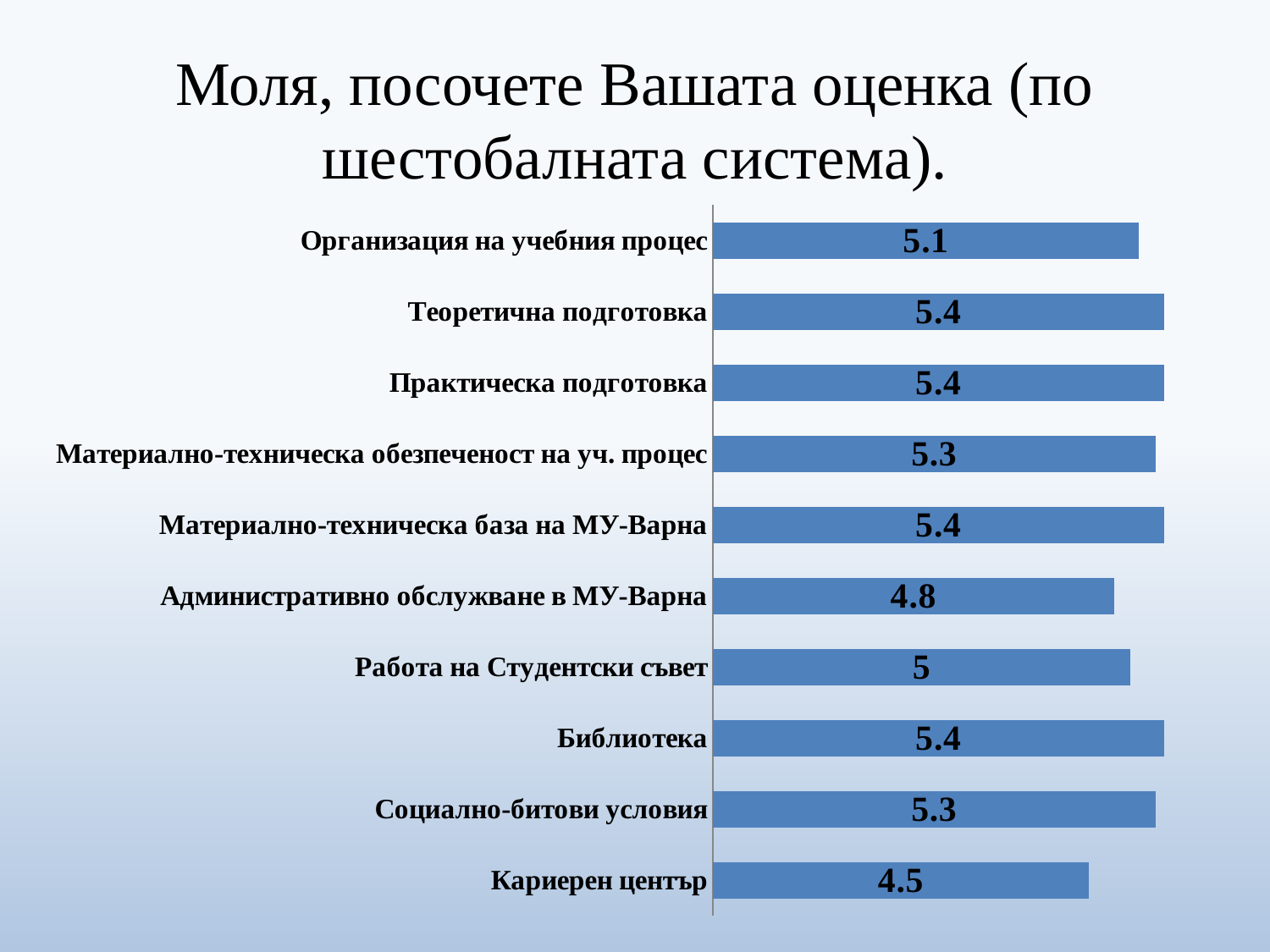
What colour are the bars in the chart? Blue What is the value for Административно обслужване в МУ-Варна? 4.8 What is the value for Организация на учебния процес? 5.1 Which category has the lowest value? Кариерен център Which is larger, the value for Теоретична подготовка or the value for Работа на Студентски съвет? Теоретична подготовка What is the difference between the values for Организация на учебния процес and Административно обслужване в МУ-Варна? 0.3 What is the value for Кариерен център? 4.5 How many categories are shown in the chart? 10 What is the difference between the values for Библиотека and Кариерен център? 0.9 What kind of chart is shown on the slide? Bar chart What is the value for Работа на Студентски съвет? 5 What is the value for Социално-битови условия? 5.3